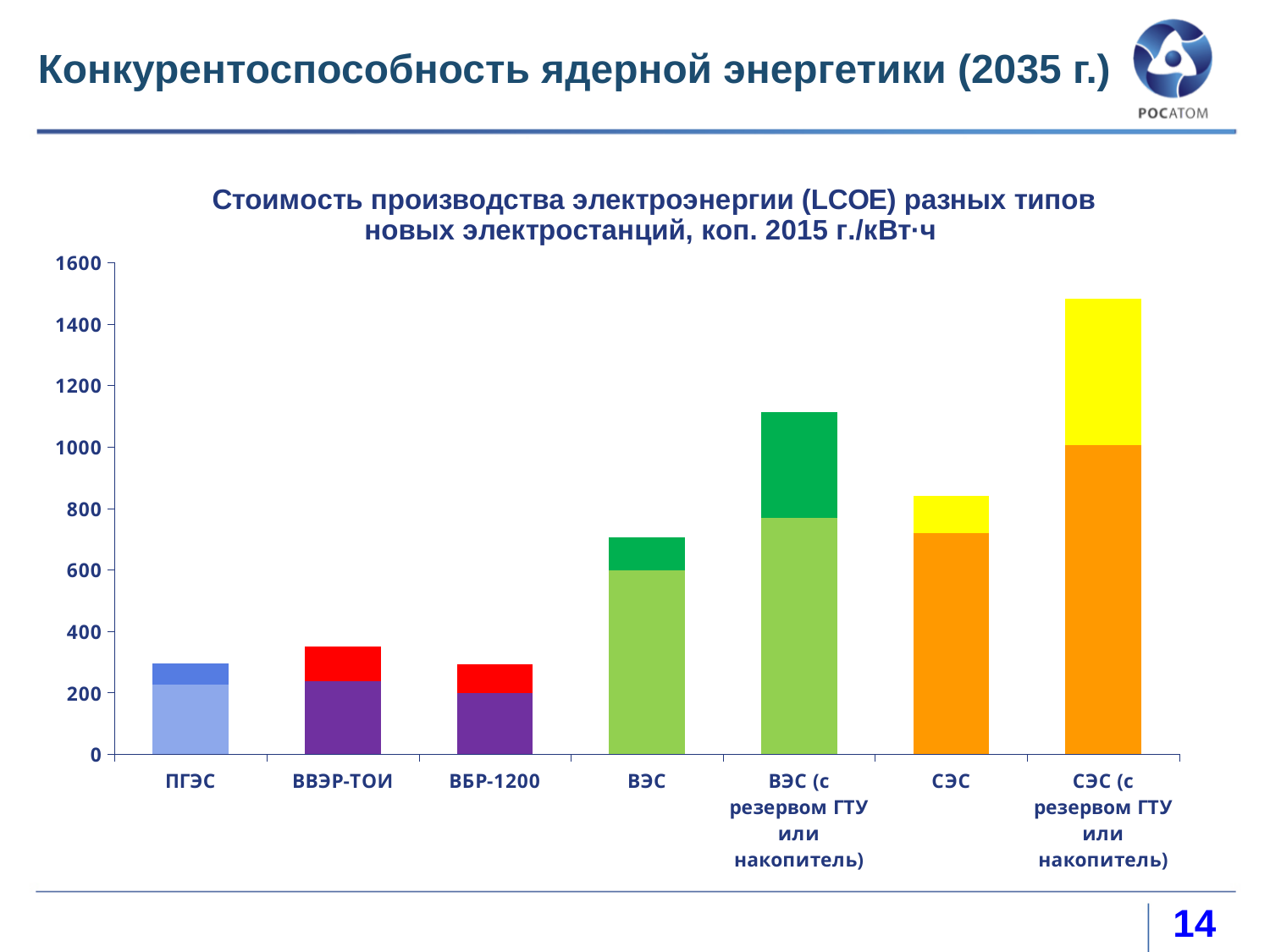
Is the total value for ВВЭР-ТОИ greater or less than 400? less Which category has the highest total bar in the chart? СЭС (с резервом ГТУ или накопитель) What is the title of the chart? Стоимость производства электроэнергии (LCOE) разных типов новых электростанций, коп. 2015 г./кВт·ч Is the total value for ВЭС (с резервом ГТУ или накопитель) greater or less than 1000? greater Which has the larger total bar, ВЭС or СЭС? СЭС What is the highest value shown on the y axis of the chart? 1600 Is the total value for СЭС (с резервом ГТУ или накопитель) greater or less than 1400? greater What kind of chart is shown on the slide? Stacked bar chart Which has the larger total bar, ВВЭР-ТОИ or ВЭС? ВЭС How many power plant types (categories) are shown on the x axis of the chart? 7